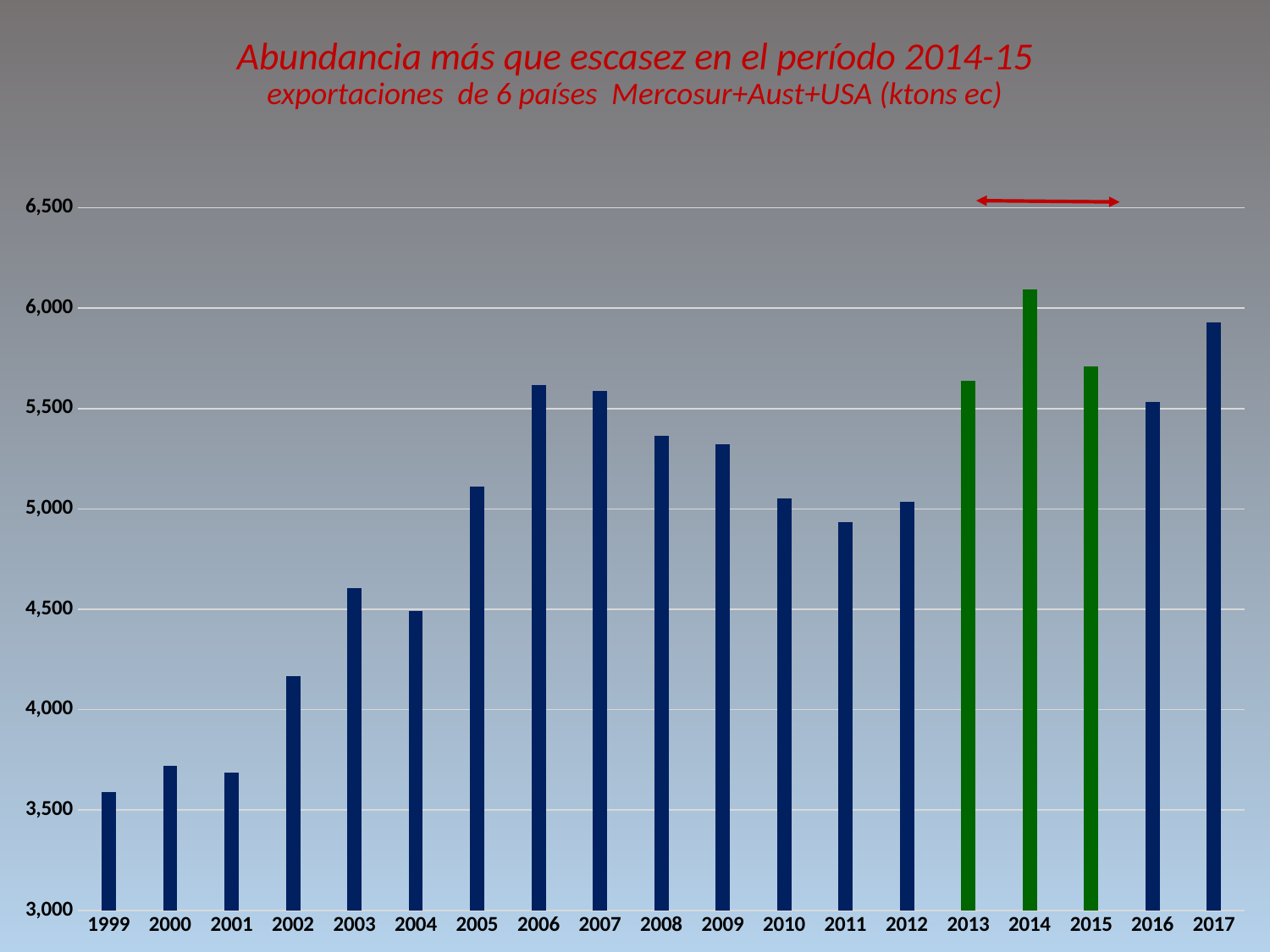
Is the value for 2002 greater or less than 4,000? greater Which year has the larger value, 2014 or 2017? 2014 Is the value for 2011 greater or less than 5,000? less Which year has the highest exports value? 2014 Which years are shown with green bars instead of blue? 2013, 2014, 2015 Do the values rise or fall from 1999 to 2003? rise Which year has the lowest exports value? 1999 What kind of chart is shown on the slide? bar chart Is the value for 2014 greater or less than 6,000? greater Which year has the larger value, 2003 or 2004? 2003 How many years (bars) are plotted on the chart? 19